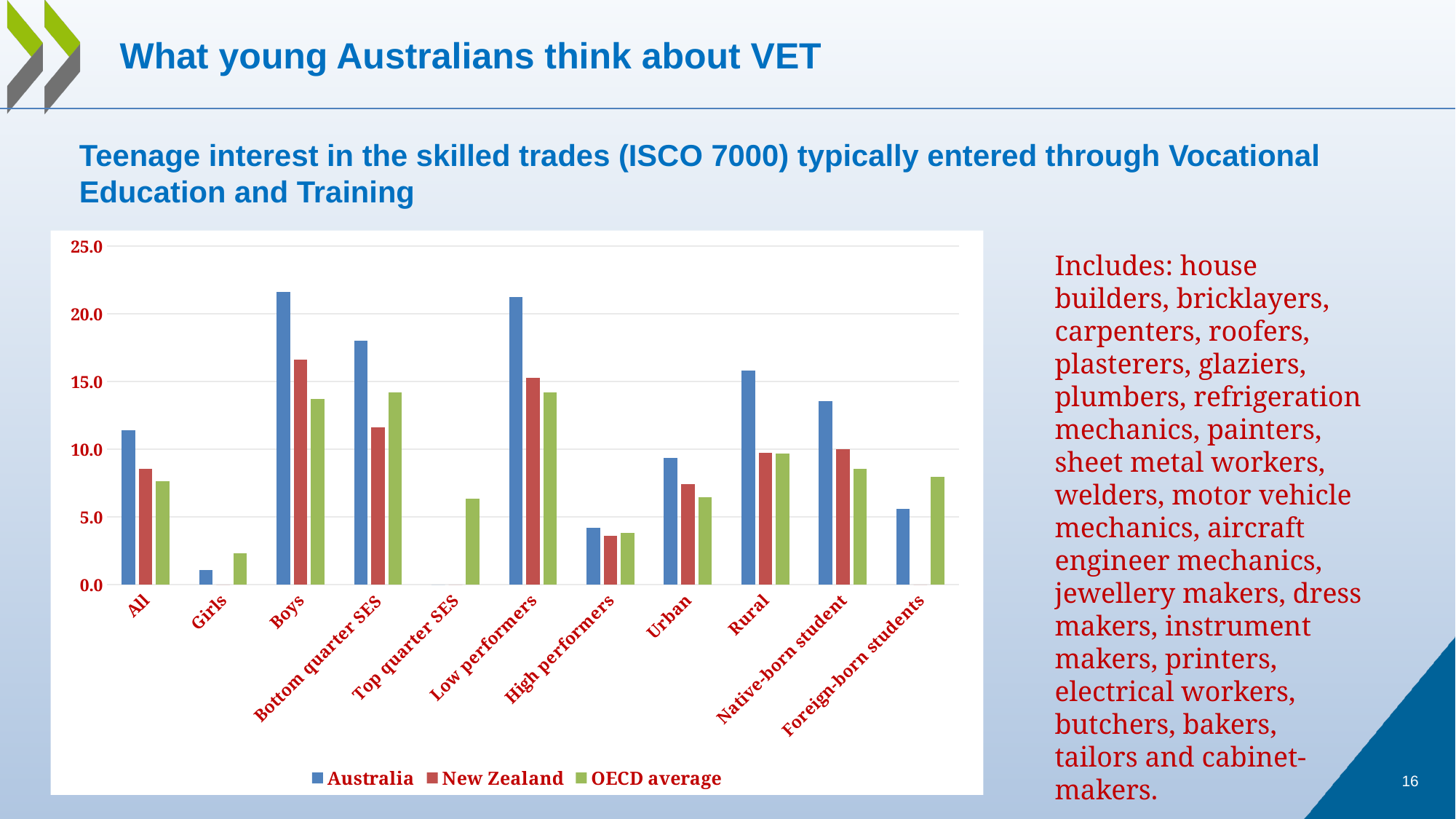
What kind of chart is shown on the slide? bar chart Is the value for Australia in the Girls category greater or less than 5? less How many categories are shown along the x axis? 11 For the All category, which is larger: Australia or New Zealand? Australia Is the value for Australia in the Urban category greater or less than 10? less Which series is shown in green in the legend? OECD average For the Low performers category, which is larger: Australia or OECD average? Australia Is the value for Australia in the Boys category greater or less than 20? greater How many series does the legend list? 3